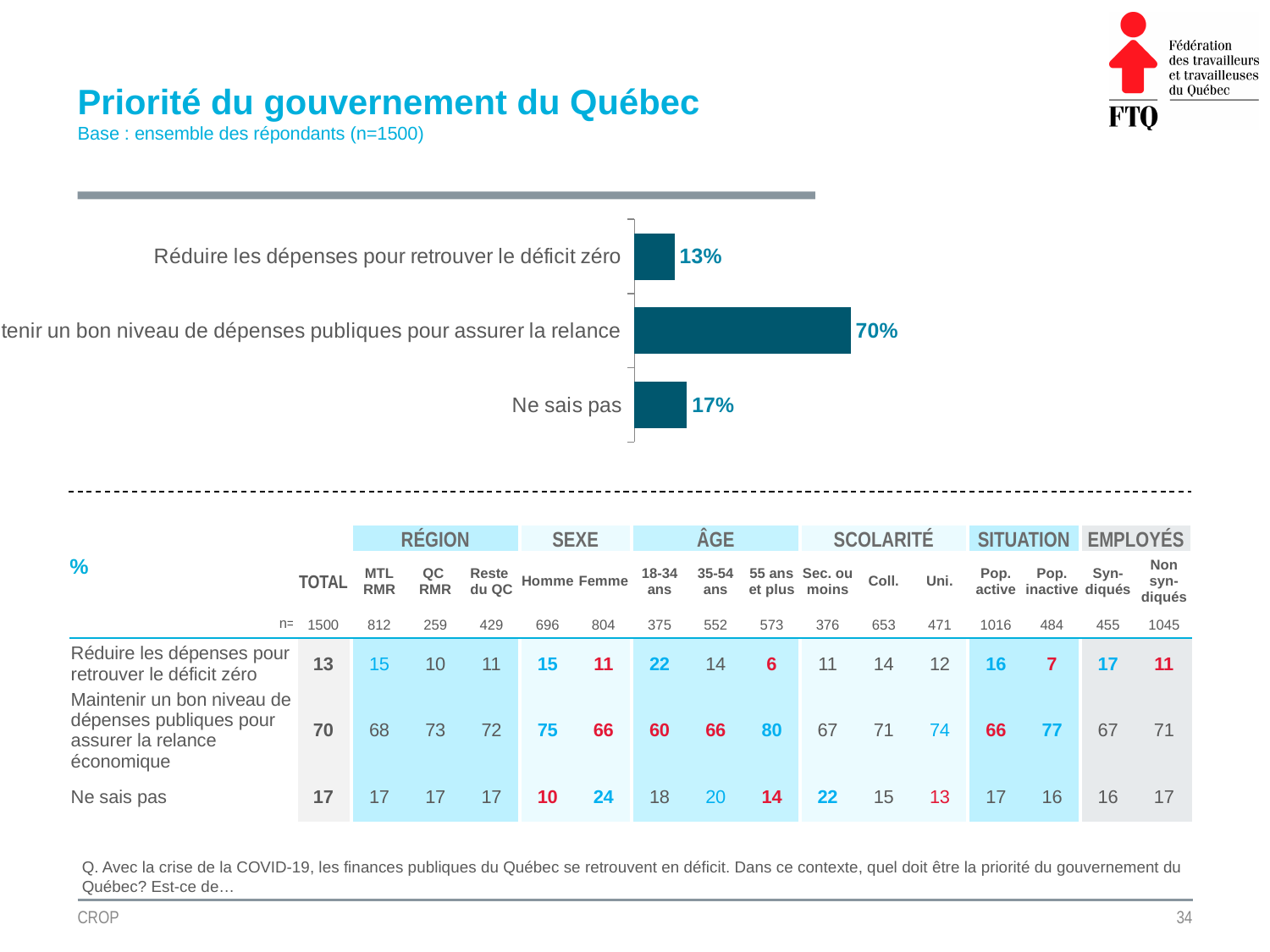
What is the title of the slide containing the bar chart? Priorité du gouvernement du Québec How many categories does the bar chart show? 3 What is the difference between the highest and lowest values in the bar chart? 57% What kind of chart is shown on the slide? Bar chart What is the value for "Ne sais pas" in the bar chart? 17% What is the value for the bar labelled "...tenir un bon niveau de dépenses publiques pour assurer la relance"? 70% Which category has the highest value in the bar chart? Maintenir un bon niveau de dépenses publiques pour assurer la relance Which is larger: the value for "Ne sais pas" or the value for "Réduire les dépenses pour retrouver le déficit zéro"? Ne sais pas What is the base (n) stated under the chart title? n=1500 What is the value for "Réduire les dépenses pour retrouver le déficit zéro" in the bar chart? 13% Which category has the lowest value in the bar chart? Réduire les dépenses pour retrouver le déficit zéro What is the difference between the value for "Ne sais pas" and the value for "Réduire les dépenses pour retrouver le déficit zéro"? 4%